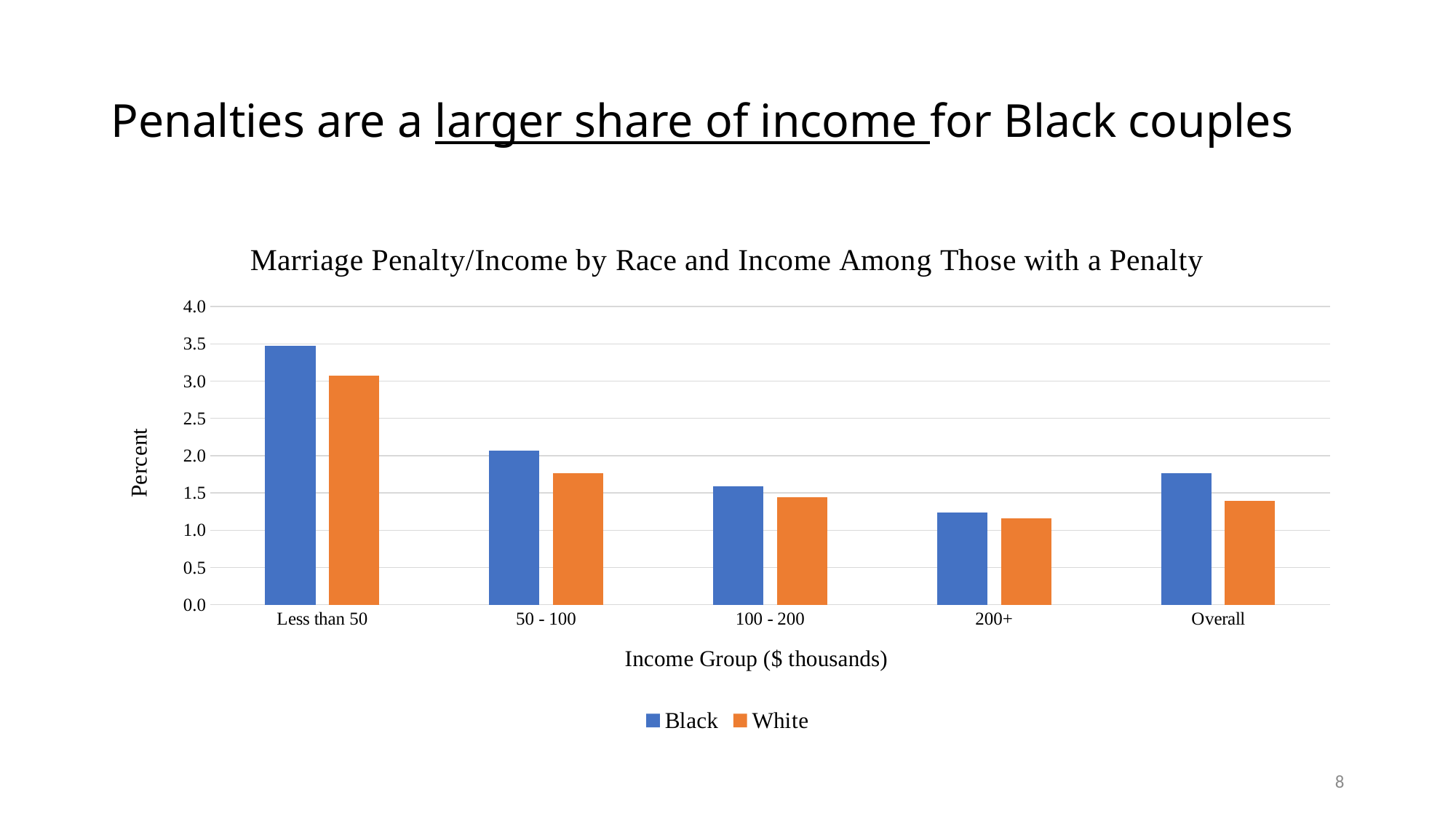
How many series does the legend list? 2 Which income group has the lowest value for the White series? 200+ In the Overall group, which series has the larger value, Black or White? Black How many income group categories are shown on the x axis? 5 Which income group has the highest value for the Black series? Less than 50 Is the value for White in the Less than 50 group greater or less than 3.5? less What is the label of the y axis? Percent Is the value for Black in the 200+ group greater or less than 1.5? less Is the value for Black in the Less than 50 group greater or less than 3.0? greater Do the values for the Black series rise or fall as income moves from Less than 50 to 200+? fall What kind of chart is shown on the slide? bar chart